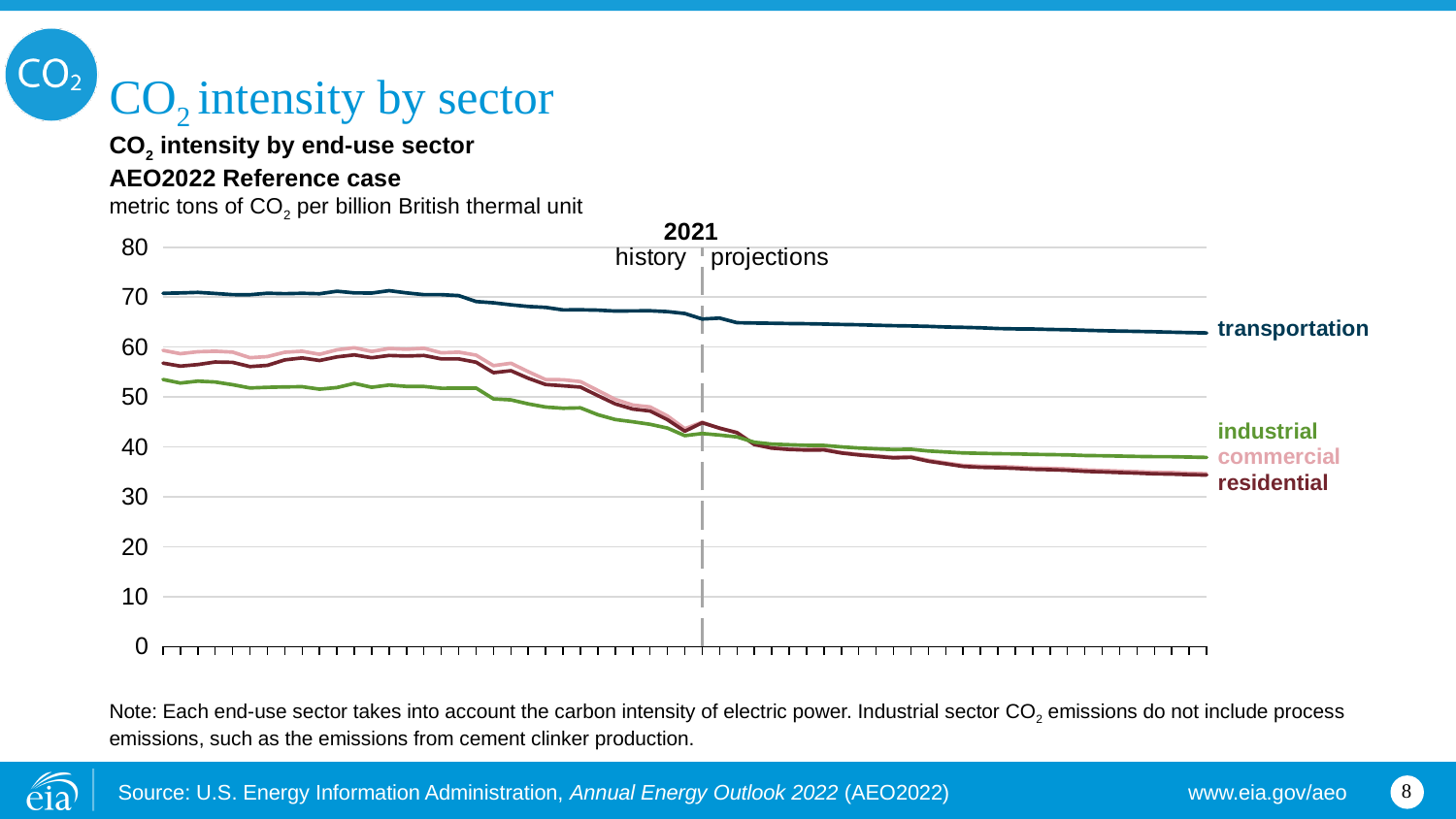
What kind of chart is shown on the slide? line chart Which sector has the lowest CO2 intensity at the end of the projection period? residential What unit is the CO2 intensity measured in on the chart? metric tons of CO2 per billion British thermal unit Which year marks the boundary between history and projections on the chart? 2021 Does the CO2 intensity of the residential sector rise or fall over the period shown? fall Which sector has the highest CO2 intensity throughout the chart? transportation Is the transportation sector's CO2 intensity at the end of the projection period greater or less than 60? greater Is the residential sector's CO2 intensity at the end of the projection period greater or less than 40? less How many sectors are plotted as lines on the chart? 4 At the end of the projection period, which has the higher CO2 intensity: transportation or industrial? transportation Does the CO2 intensity of the transportation sector rise or fall over the period shown? fall Is the industrial sector's CO2 intensity at the start of the history period greater or less than 50? greater